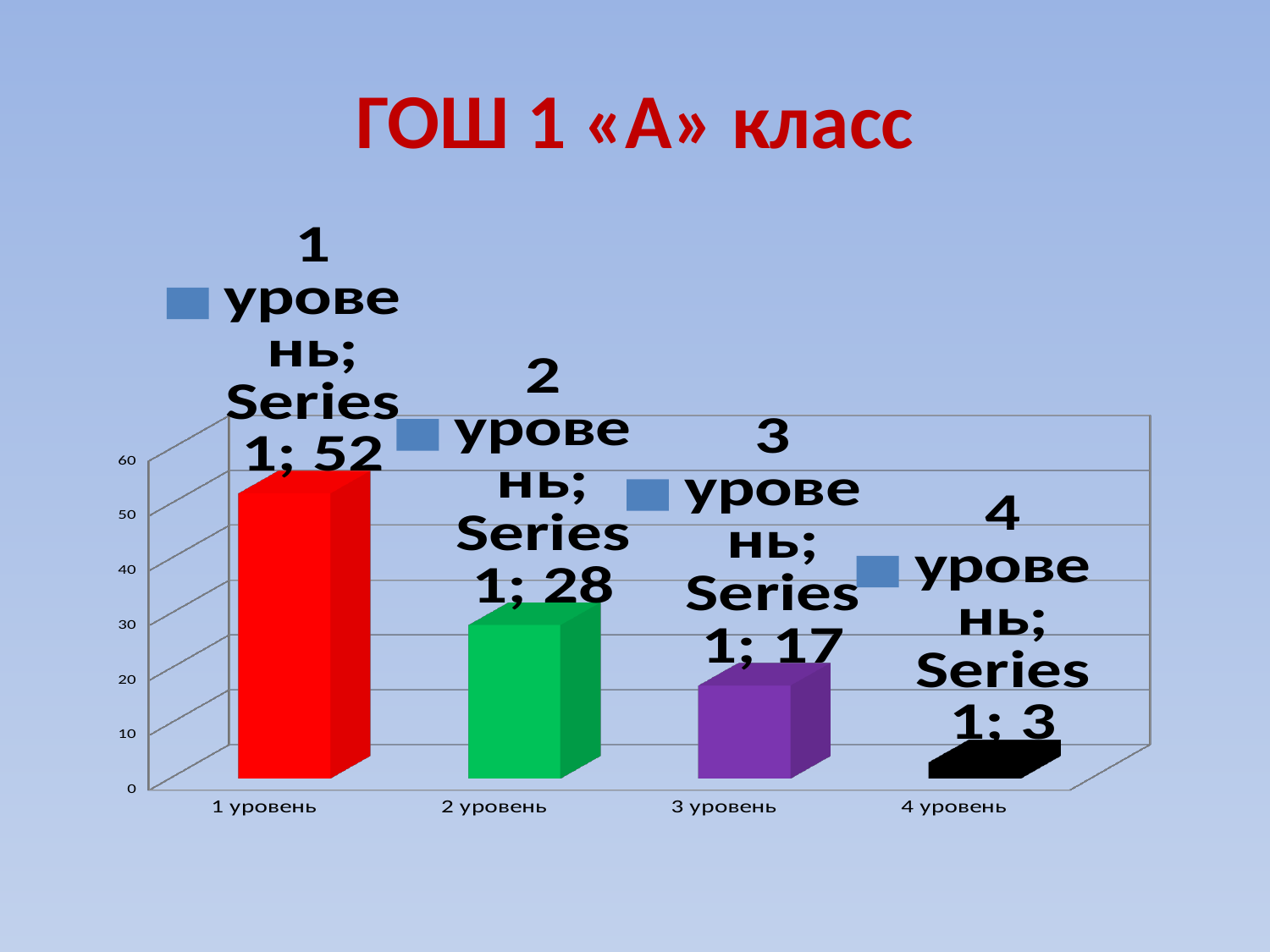
Which category has the lowest value? 4 уровень Which is larger, the value for 2 уровень or the value for 3 уровень? 2 уровень Which category has the highest value? 1 уровень What is the value for 4 уровень? 3 How many categories are shown on the x axis? 4 What is the value for 1 уровень? 52 Do the values rise or fall from 1 уровень to 4 уровень? fall What is the difference between the values for 1 уровень and 2 уровень? 24 What is the value for 3 уровень? 17 What is the value for 2 уровень? 28 What kind of chart is shown on the slide? bar chart Is the value for 1 уровень greater or less than 50? greater